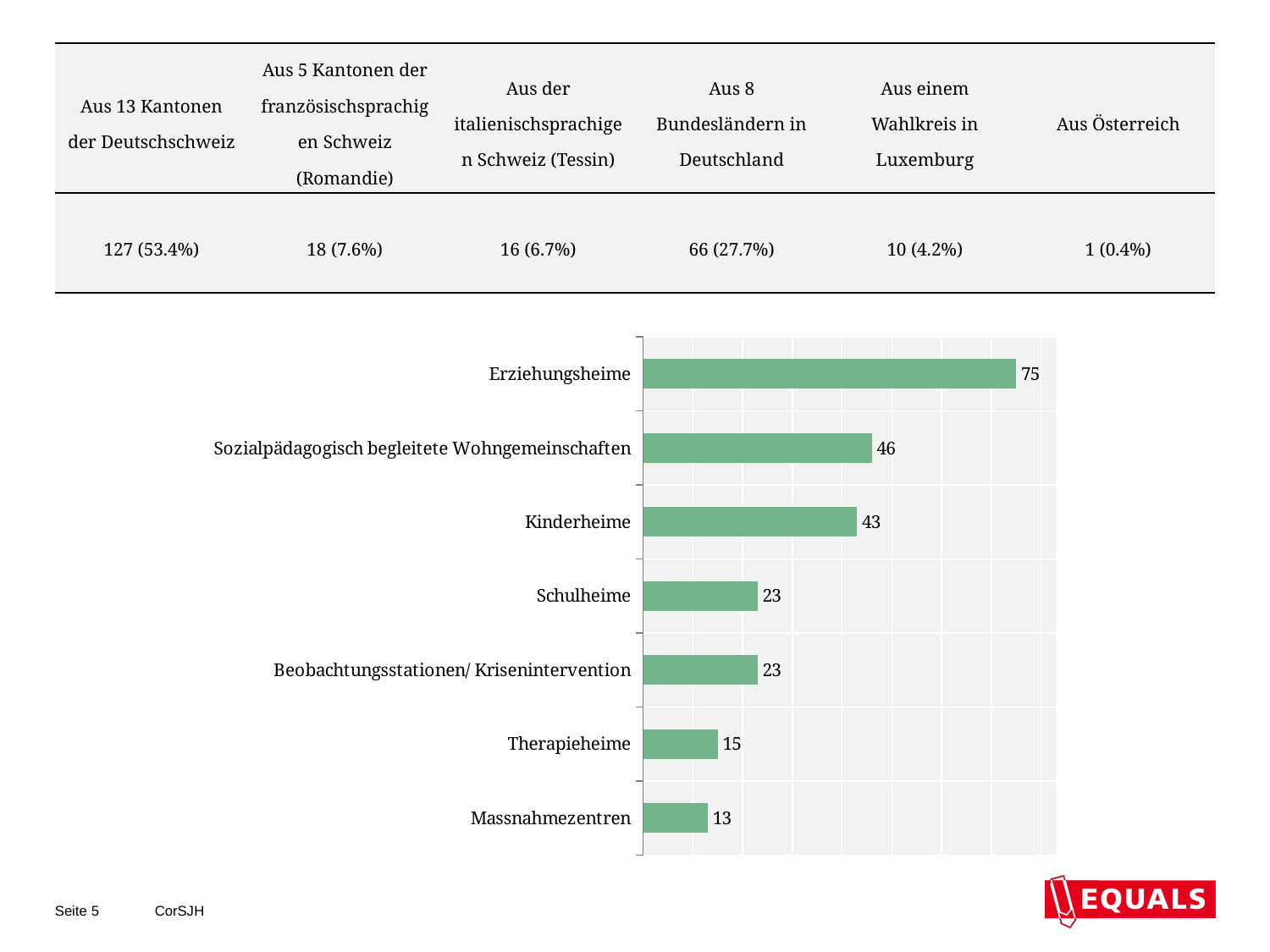
Which category has the lowest value? Massnahmezentren What is the difference between the values for Schulheime and Massnahmezentren? 10 What is the value for Erziehungsheime? 75 What kind of chart is shown on the slide? bar chart Which is larger, the value for Sozialpädagogisch begleitete Wohngemeinschaften or the value for Kinderheime? Sozialpädagogisch begleitete Wohngemeinschaften How many categories are shown in the chart? 7 What is the difference between the values for Erziehungsheime and Kinderheime? 32 What is the value for Kinderheime? 43 What is the value for Therapieheime? 15 What is the value for Sozialpädagogisch begleitete Wohngemeinschaften? 46 Which category has the highest value? Erziehungsheime Which two categories have the same value of 23? Schulheime and Beobachtungsstationen/Krisenintervention